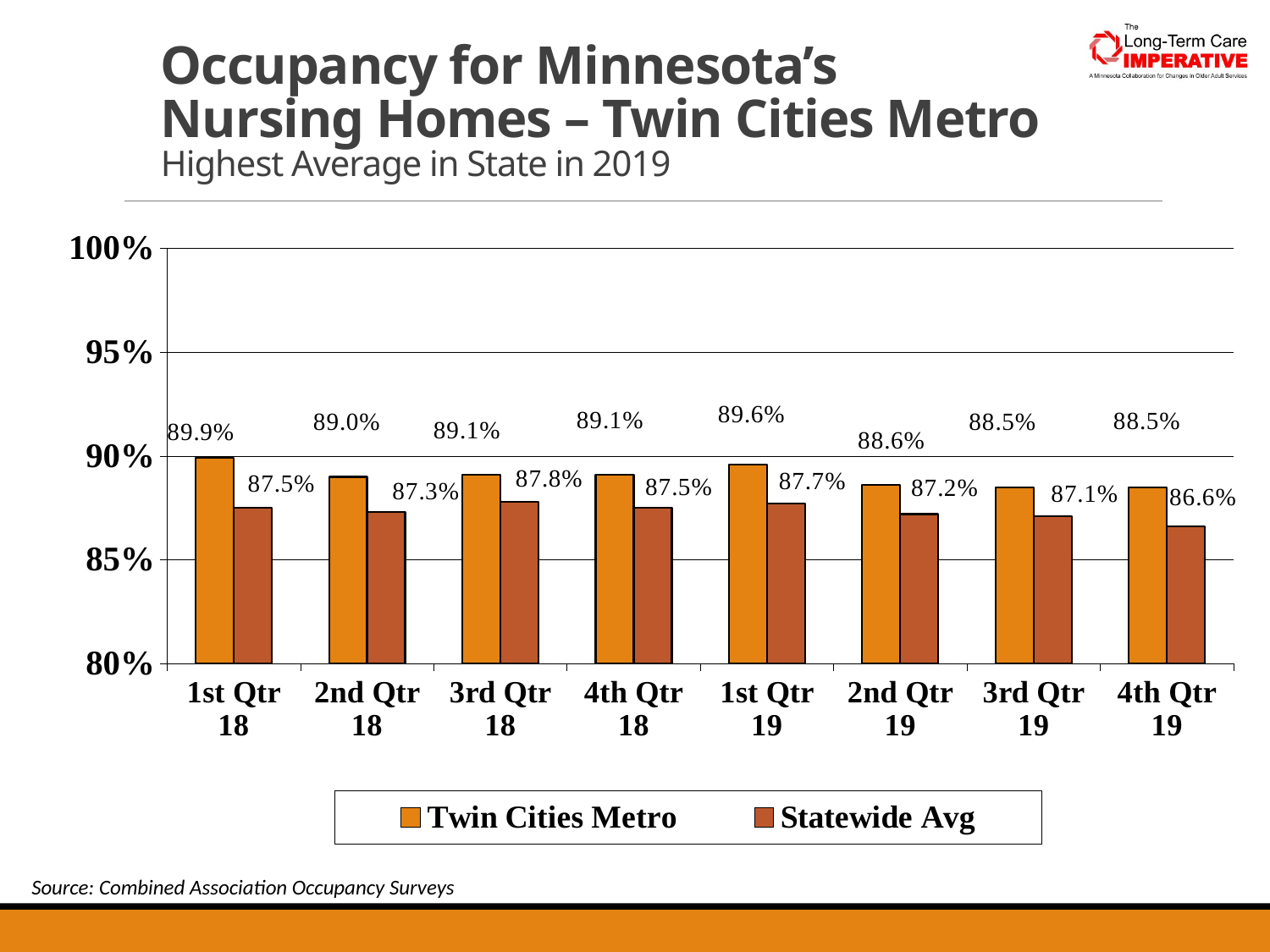
What is the source cited below the chart? Combined Association Occupancy Surveys What kind of chart is shown on the slide? Bar chart What is the difference between the Twin Cities Metro and Statewide Avg values in 1st Qtr 18? 2.4% How many series does the legend list? 2 Which quarter has the highest Twin Cities Metro occupancy? 1st Qtr 18 Which is larger in 3rd Qtr 19: the Twin Cities Metro value or the Statewide Avg value? Twin Cities Metro What is the Statewide Avg occupancy value for 4th Qtr 19? 86.6% Is the Statewide Avg value for 2nd Qtr 18 greater or less than 90%? less What is the Twin Cities Metro occupancy value for 1st Qtr 18? 89.9% What is the Twin Cities Metro value for 1st Qtr 19? 89.6% How many quarters are shown on the x axis? 8 Which quarter has the lowest Statewide Avg occupancy? 4th Qtr 19